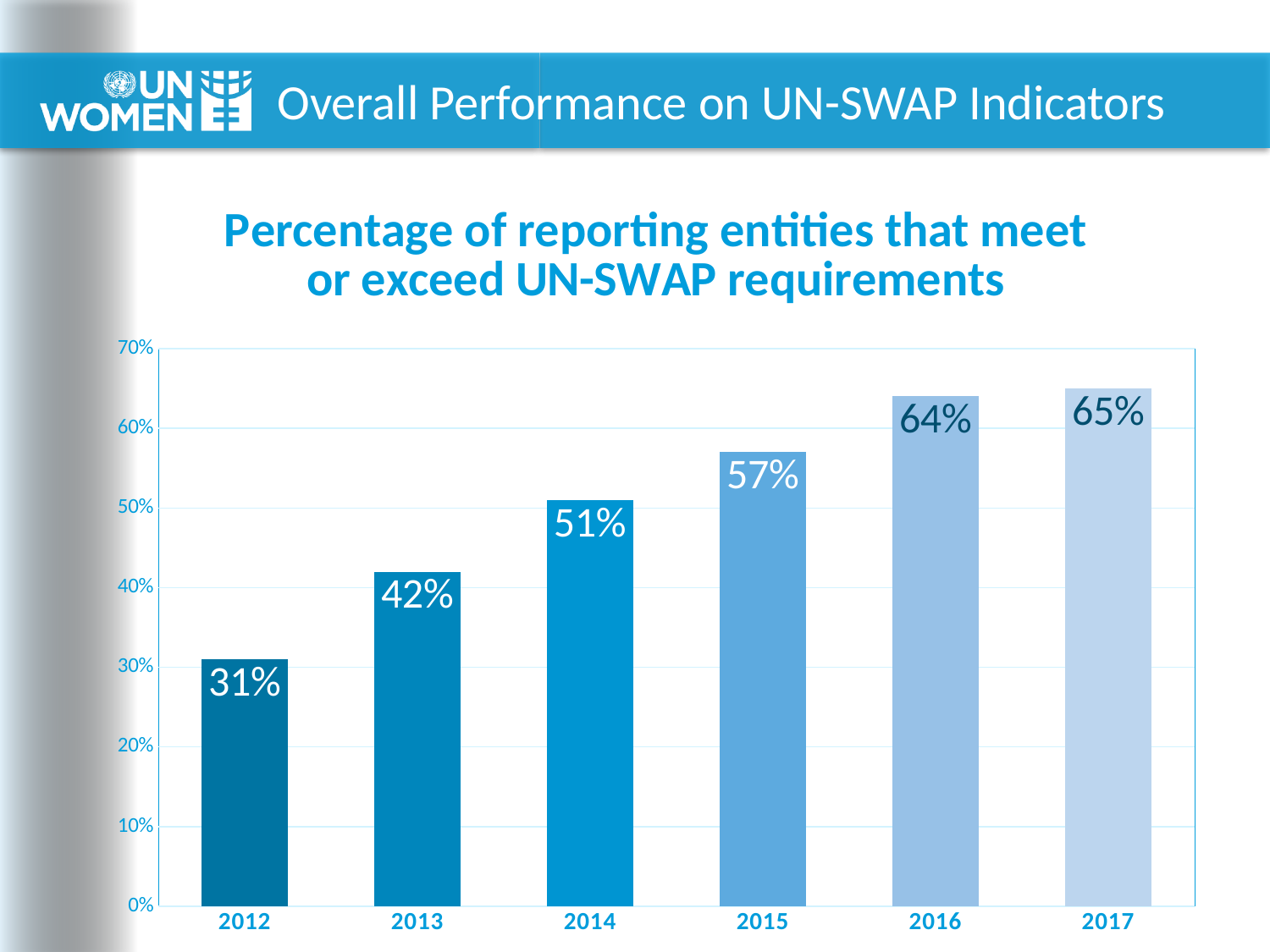
Is the value for 2015 greater or less than 50%? greater What kind of chart is shown on the slide? Bar chart What is the value shown for 2017? 65% By how many percentage points did the value increase from 2012 to 2017? 34% What percentage of reporting entities met or exceeded UN-SWAP requirements in 2012? 31% Do the values rise or fall from 2012 to 2017? Rise Which year has the lowest percentage? 2012 What is the difference between the 2014 value and the 2013 value? 9% Which year has the highest percentage of reporting entities meeting or exceeding UN-SWAP requirements? 2017 How many years are shown on the x axis of the chart? 6 Which is larger, the value for 2014 or the value for 2016? 2016 What is the value shown for 2015? 57%